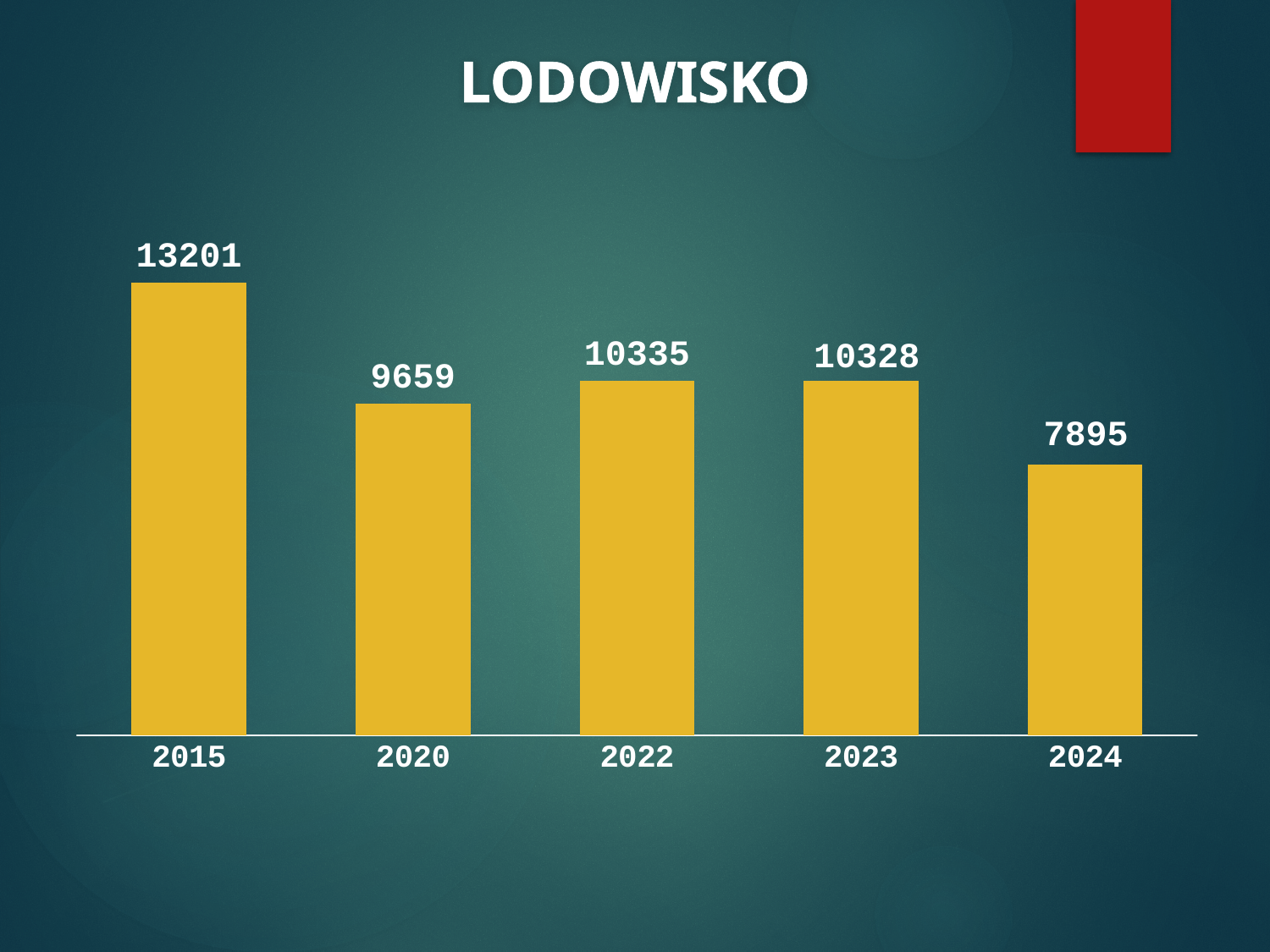
How many years are shown on the chart? 5 What is the difference between the values for 2015 and 2024? 5306 Which is larger, the value for 2020 or the value for 2022? 2022 Which year has the highest value? 2015 What is the difference between the values for 2022 and 2023? 7 What is the value for 2020? 9659 Does the value fall or rise from 2023 to 2024? fall What is the value for 2024? 7895 What kind of chart is this? bar chart What is the title of the chart? LODOWISKO What is the value for 2015? 13201 Which year has the lowest value? 2024